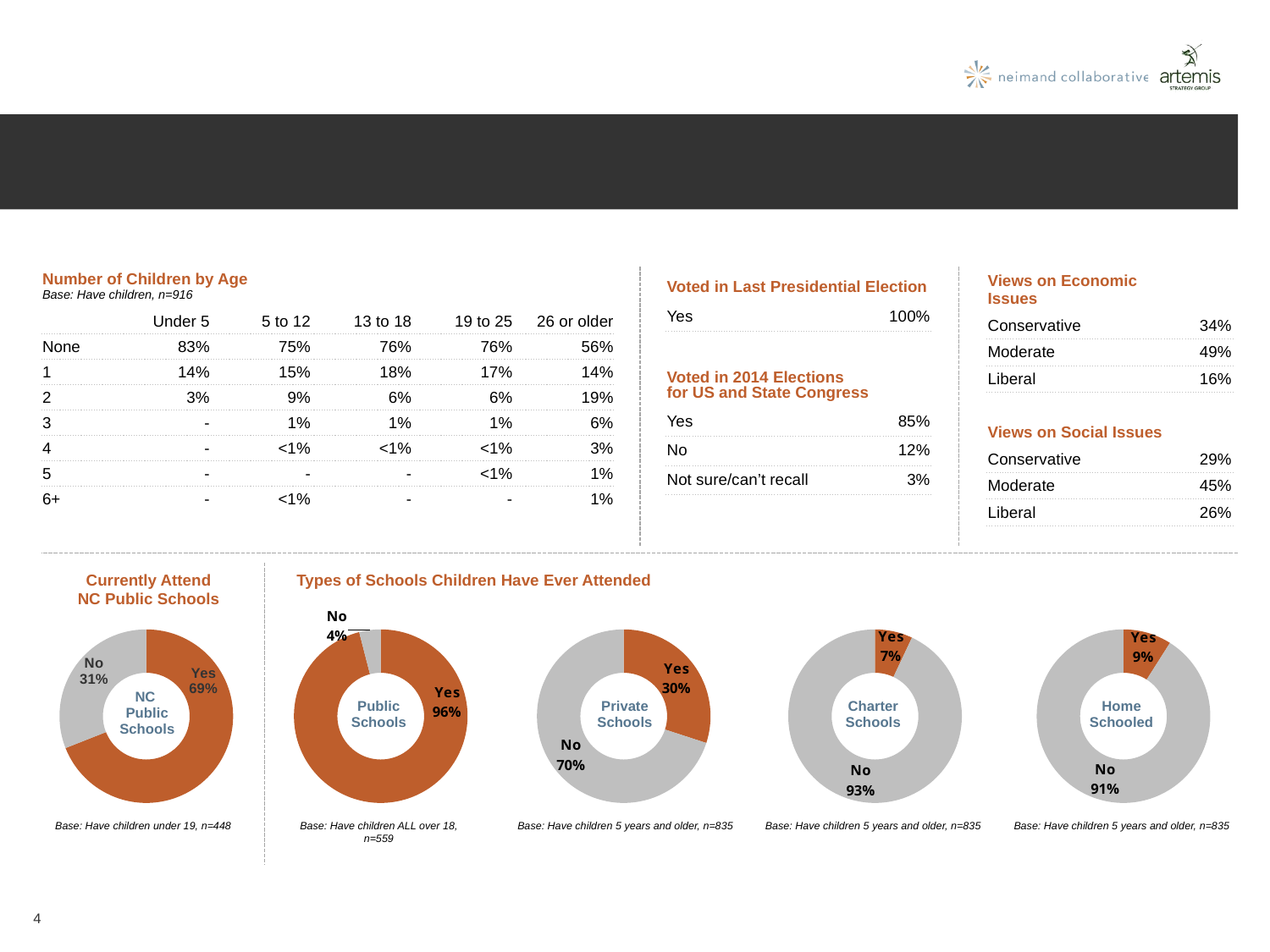
Which of the four 'Types of Schools Children Have Ever Attended' donut charts has the highest Yes percentage? Public Schools In the 'Currently Attend NC Public Schools' donut chart, what percentage answered Yes? 69% In the Public Schools donut chart under 'Types of Schools Children Have Ever Attended', what percentage answered Yes? 96% Which of the four 'Types of Schools Children Have Ever Attended' donut charts has the lowest Yes percentage? Charter Schools In the Charter Schools donut chart, what percentage answered Yes? 7% In the Public Schools donut chart, which slice is larger, Yes or No? Yes In the Home Schooled donut chart, what percentage answered No? 91% In the Private Schools donut chart, what percentage answered No? 70% What type of chart is used to show 'Currently Attend NC Public Schools'? Donut (pie) chart How many donut charts are shown under the heading 'Types of Schools Children Have Ever Attended'? 4 In the 'Currently Attend NC Public Schools' donut chart, what percentage answered No? 31% In the Private Schools donut chart, what is the difference between the No and Yes percentages? 40%